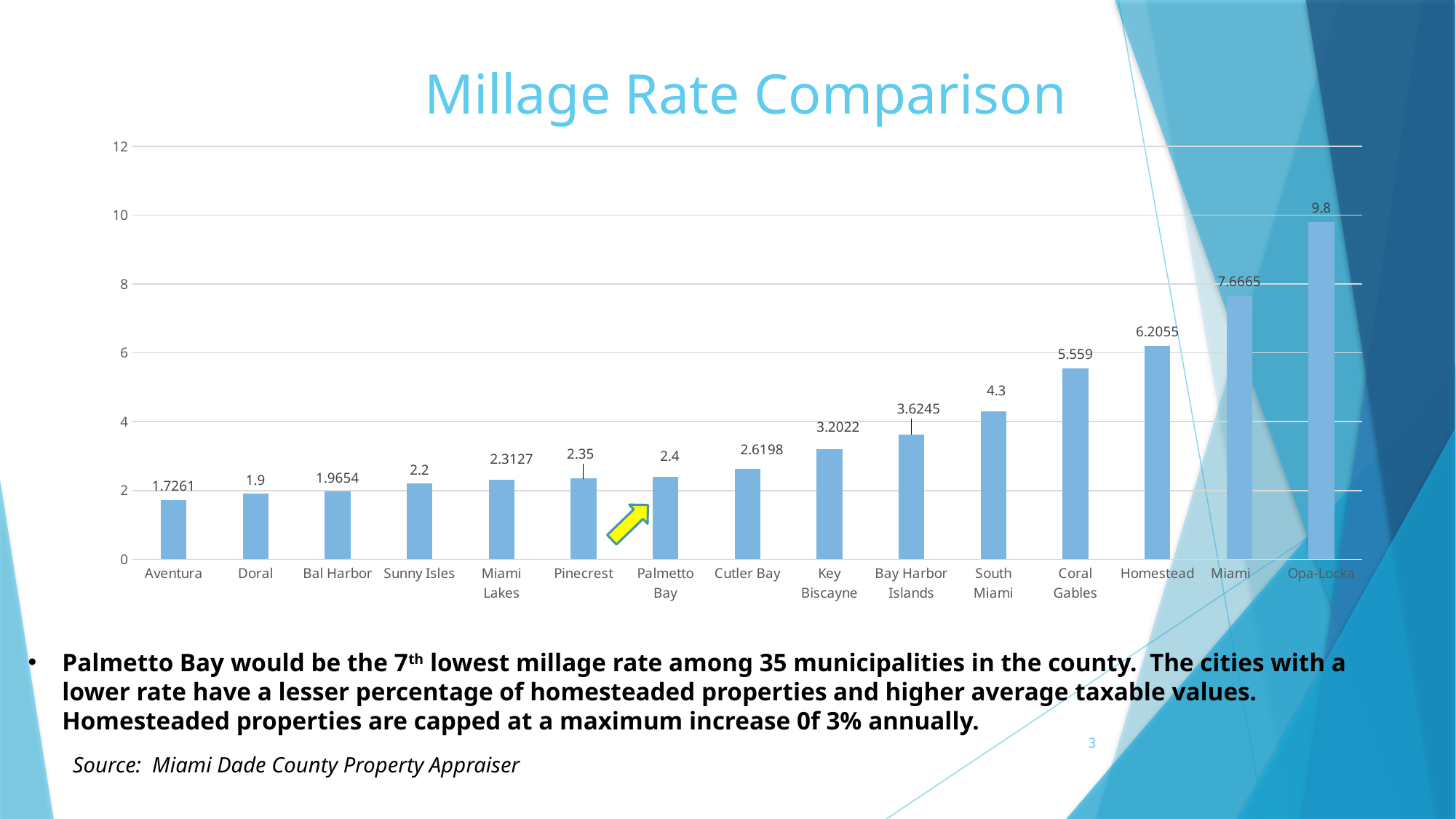
Which municipality has the highest millage rate in the chart? Opa-Locka What is the millage rate shown for Coral Gables? 5.559 Do the millage rates rise or fall moving from left to right across the chart? Rise What is the difference between the millage rates of Opa-Locka and Miami? 2.1335 What is the millage rate shown for Palmetto Bay? 2.4 How many municipalities are shown in the chart? 15 Is the millage rate for South Miami greater or less than 4? greater Which municipality has the lowest millage rate in the chart? Aventura What is the millage rate shown for Aventura? 1.7261 What type of chart is used on this slide? Bar chart Which has a higher millage rate, Key Biscayne or Bay Harbor Islands? Bay Harbor Islands What is the difference between the millage rates of Homestead and Coral Gables? 0.6465